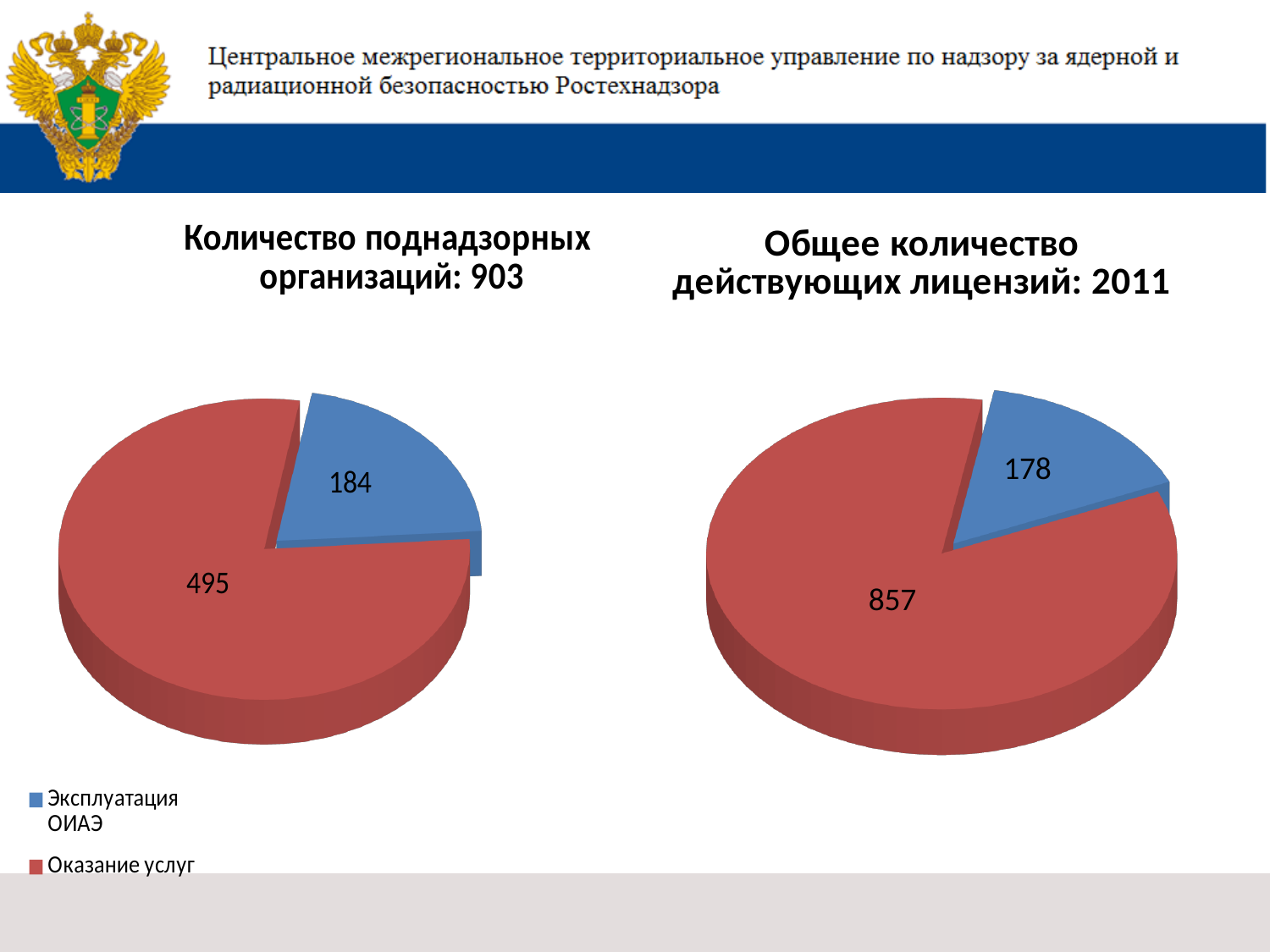
In the chart 'Количество поднадзорных организаций: 903', what is the value for Оказание услуг? 495 In the chart 'Общее количество действующих лицензий: 2011', what is the value for Эксплуатация ОИАЭ? 178 In the chart 'Количество поднадзорных организаций: 903', what is the value for Эксплуатация ОИАЭ? 184 In the chart 'Общее количество действующих лицензий: 2011', which category has the smallest slice? Эксплуатация ОИАЭ How many slices does the chart 'Общее количество действующих лицензий: 2011' have? 2 What kind of chart is used for 'Количество поднадзорных организаций: 903'? pie chart Which is larger: Эксплуатация ОИАЭ in the left chart or Эксплуатация ОИАЭ in the right chart? the left chart (184) Which colour represents Оказание услуг in the legend? red In the chart 'Количество поднадзорных организаций: 903', what is the difference between Оказание услуг and Эксплуатация ОИАЭ? 311 In the chart 'Количество поднадзорных организаций: 903', which category has the largest slice? Оказание услуг In the chart 'Общее количество действующих лицензий: 2011', what is the difference between Оказание услуг and Эксплуатация ОИАЭ? 679 In the chart 'Общее количество действующих лицензий: 2011', what is the value for Оказание услуг? 857